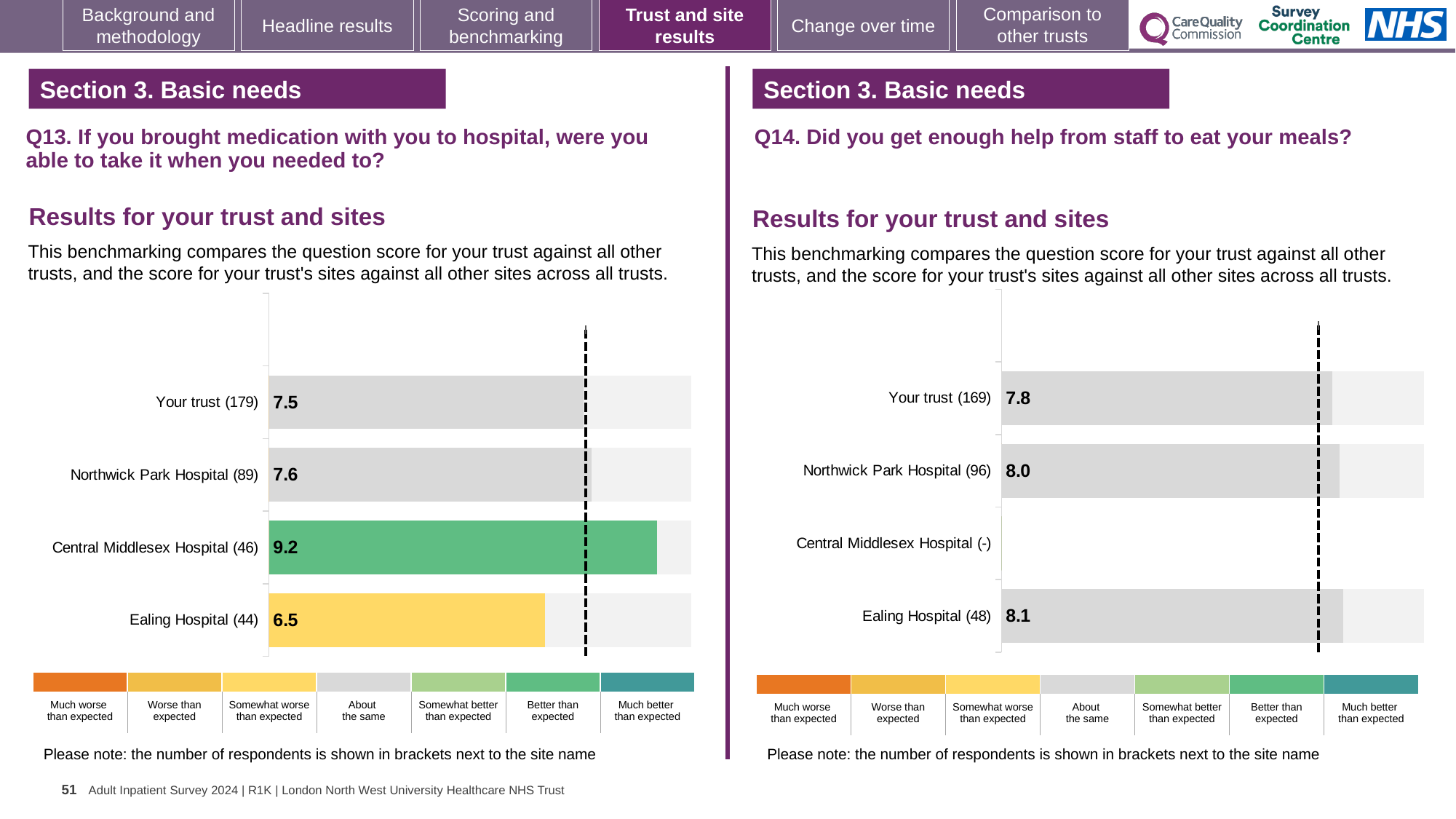
In the Q13 chart, which site or trust has the highest score? Central Middlesex Hospital In the Q13 chart, which site or trust has the lowest score? Ealing Hospital In the Q13 chart, what is the difference between the scores for Central Middlesex Hospital and Ealing Hospital? 2.7 In the Q14 chart, how many respondents are shown in brackets for Your trust? 169 In the Q14 chart, what is the difference between the scores for Ealing Hospital and Your trust? 0.3 In the Q13 chart, what is the score for Central Middlesex Hospital? 9.2 What type of chart is used for the Q13 results? Bar chart In the Q14 chart, what is the score for Northwick Park Hospital? 8.0 In the Q14 chart, what is the score for Your trust? 7.8 In the Q14 chart, which is higher, the score for Ealing Hospital or the score for Your trust? Ealing Hospital How many bars are plotted in the Q13 chart? 4 In the Q13 chart, what is the score for Ealing Hospital? 6.5